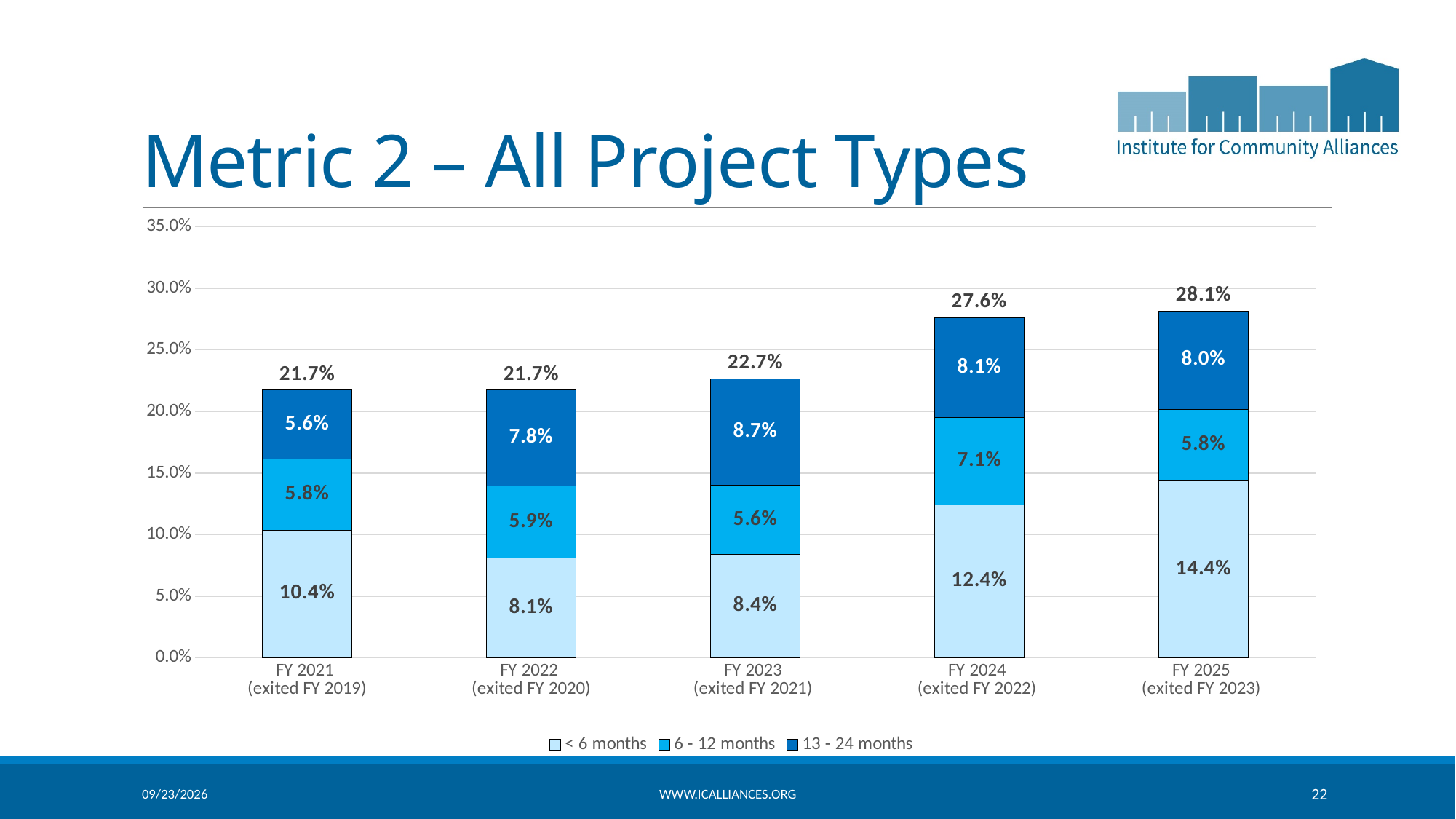
What is the total of the stacked bar for FY 2025 (exited FY 2023)? 28.1% What is the value for '< 6 months' in FY 2021 (exited FY 2019)? 10.4% What kind of chart is shown on the slide? Stacked bar chart How many series does the legend list? 3 What is the difference between the '< 6 months' values for FY 2025 (exited FY 2023) and FY 2024 (exited FY 2022)? 2.0% Which fiscal year has the lowest value for '< 6 months'? FY 2022 (exited FY 2020) Do the stacked bar totals rise or fall from FY 2023 (exited FY 2021) to FY 2025 (exited FY 2023)? Rise What is the value for '13 - 24 months' in FY 2023 (exited FY 2021)? 8.7% Which is larger: the '13 - 24 months' value for FY 2022 (exited FY 2020) or for FY 2021 (exited FY 2019)? FY 2022 (exited FY 2020) Which fiscal year has the highest stacked bar total? FY 2025 (exited FY 2023) How many fiscal year categories are shown on the x axis? 5 What is the value for '6 - 12 months' in FY 2024 (exited FY 2022)? 7.1%